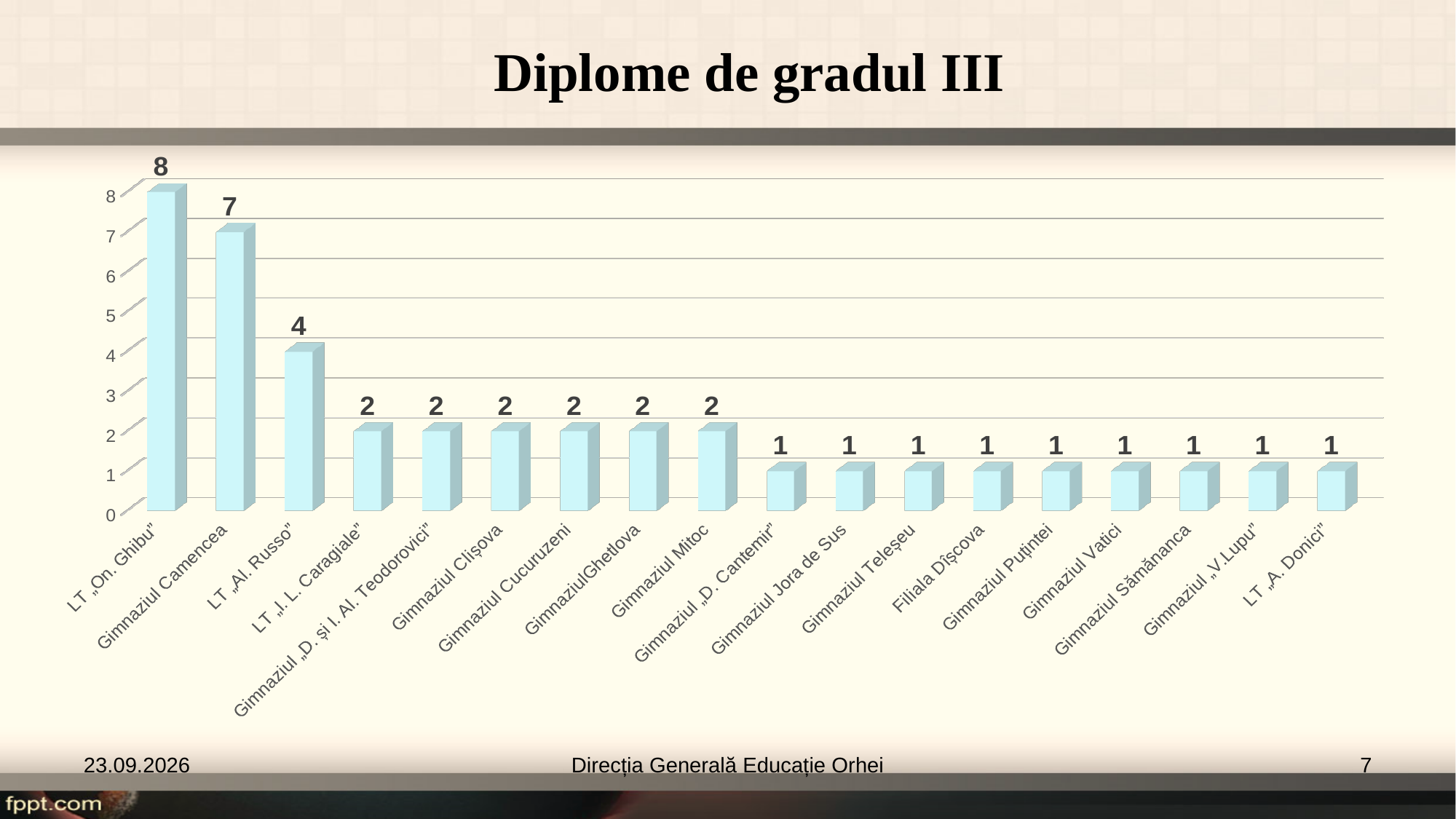
What is the value for Gimnaziul Mitoc? 2 What is the difference between LT „Al. Russo” and Gimnaziul Clișova? 2 Which category has the highest value? LT „On. Ghibu” What kind of chart is shown on the slide? bar chart Which is larger, the value for Gimnaziul Cucuruzeni or the value for Gimnaziul Vatici? Gimnaziul Cucuruzeni What is the title of the chart? Diplome de gradul III What is the value for Gimnaziul Camencea? 7 What is the value for Filiala Dîșcova? 1 What is the difference between LT „On. Ghibu” and Gimnaziul Camencea? 1 What is the value for LT „Al. Russo”? 4 How many categories are shown on the x axis? 18 How many diplomas does LT „On. Ghibu” have? 8